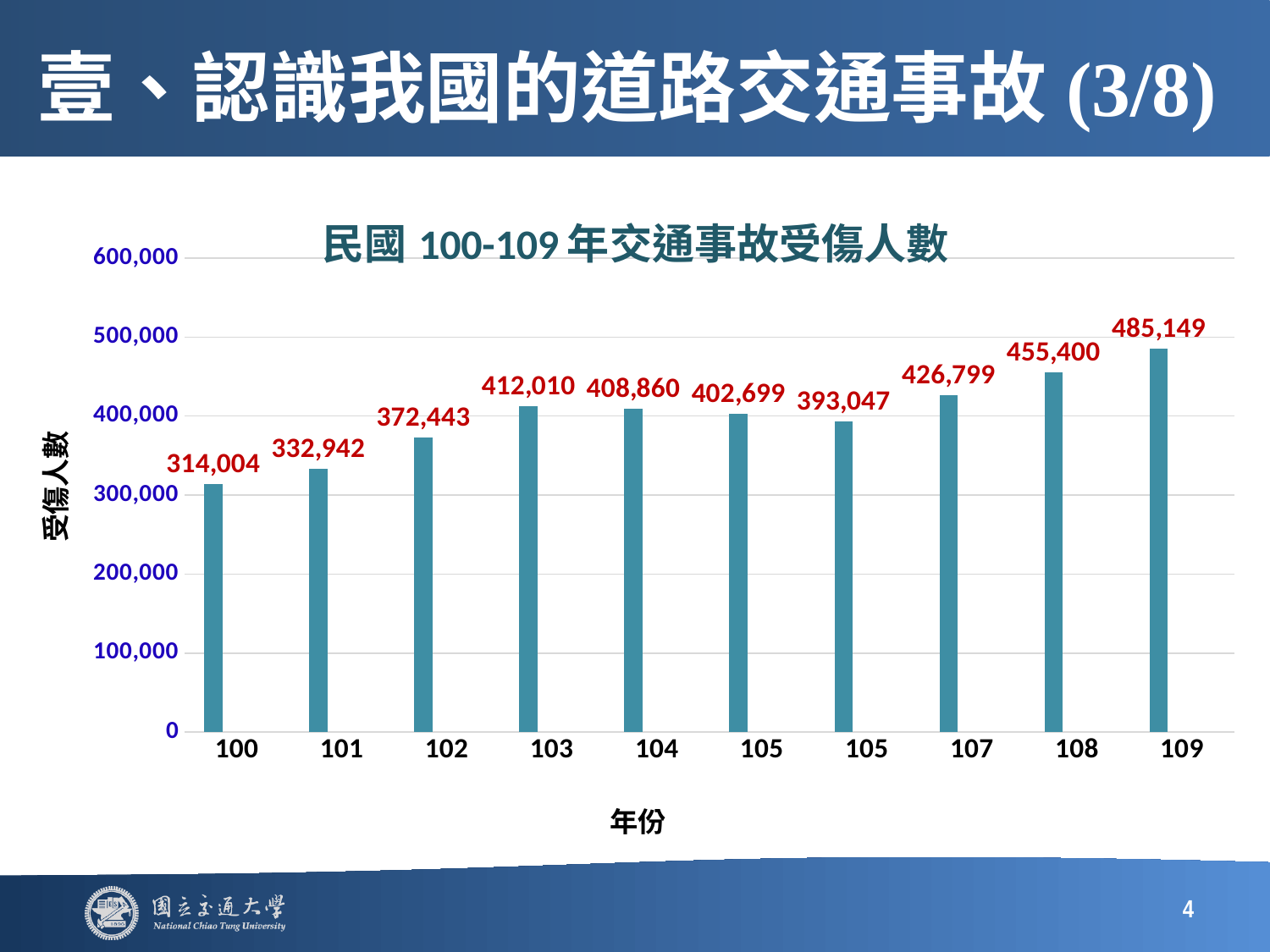
What is the difference between the number of injured persons in year 108 and year 107? 28,601 What is the title of the chart? 民國 100-109 年交通事故受傷人數 How many bars are shown in the chart? 10 Which year has the lowest number of injured persons? 100 What is the number of injured persons for year 109? 485,149 Which year has more injured persons, 103 or 104? 103 What is the difference between the number of injured persons in year 109 and year 100? 171,145 What is the number of injured persons for year 102? 372,443 What is the number of injured persons for year 100? 314,004 Which year has the highest number of injured persons? 109 What is the number of injured persons for year 107? 426,799 What type of chart is shown on the slide? Bar chart